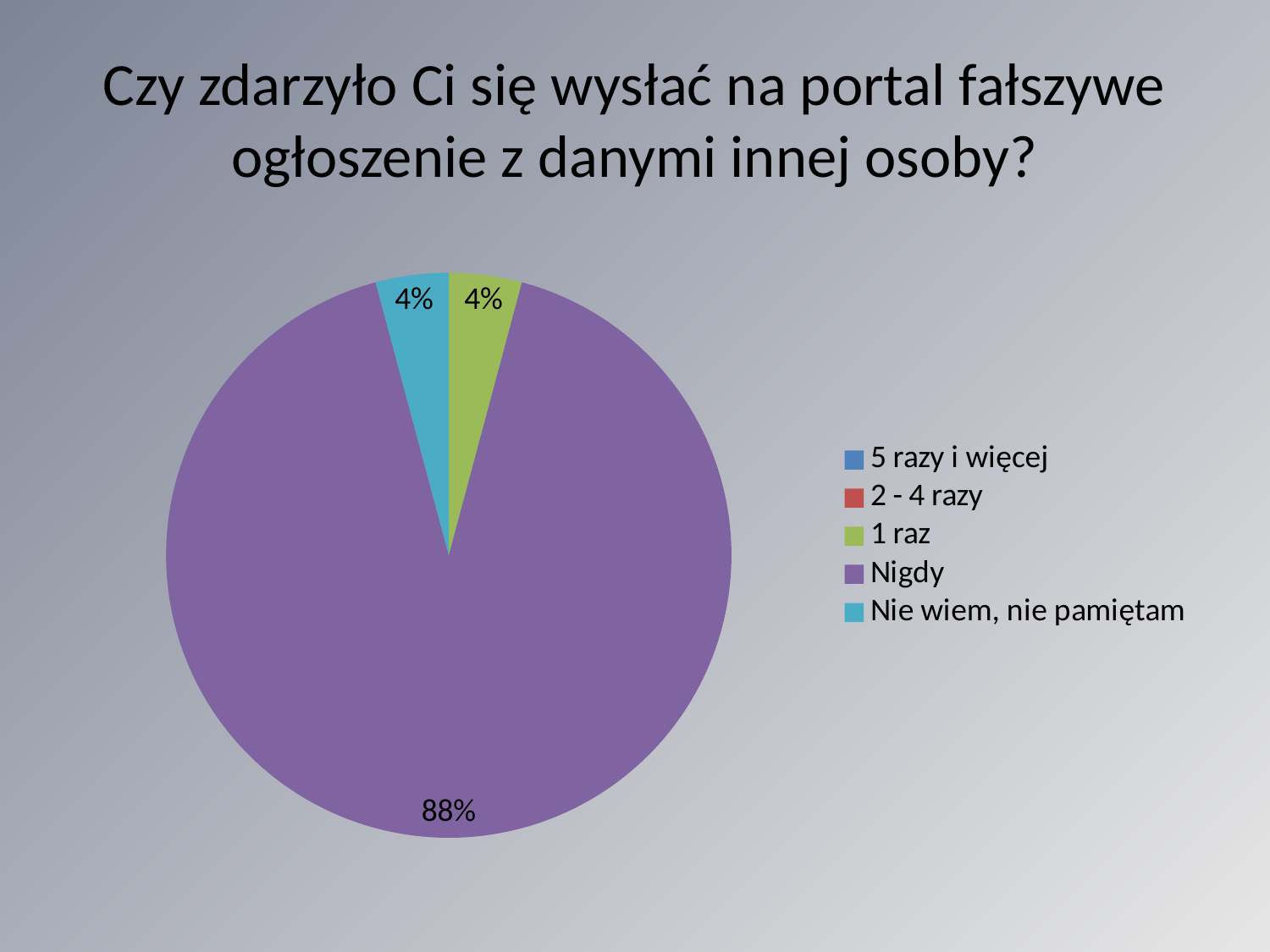
What share of the pie does the "Nigdy" slice represent? 88% What percentage of respondents answered "Nie wiem, nie pamiętam"? 4% How many categories does the legend list? 5 What is the title of the slide? Czy zdarzyło Ci się wysłać na portal fałszywe ogłoszenie z danymi innej osoby? Which is larger, the share for "Nigdy" or the share for "Nie wiem, nie pamiętam"? Nigdy What is the difference in percentage points between the "Nigdy" slice and the "1 raz" slice? 84 percentage points What colour is the "Nigdy" slice in the pie chart? Purple What percentage of respondents answered "Nigdy"? 88% What type of chart is shown on the slide? Pie chart How many slices with data labels are visible in the pie chart? 3 Which answer category has the largest share of the pie? Nigdy What percentage of respondents answered "1 raz"? 4%